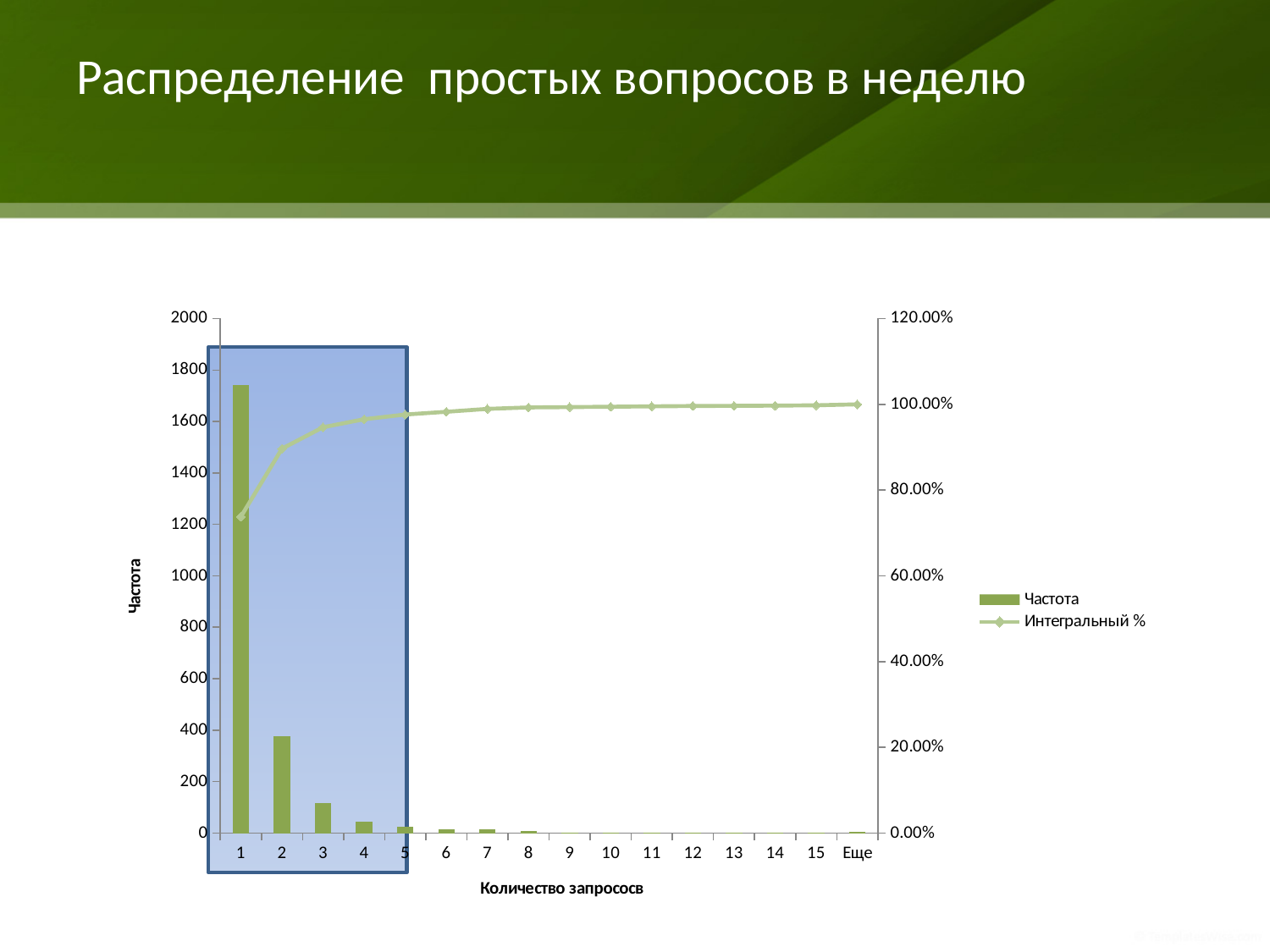
Is the Частота value for category 1 greater or less than 1600? greater Which has a larger Частота value, category 1 or category 2? Category 1 Do the Частота bars rise or fall as you move from category 1 to category 15? Fall Is the Частота value for category 2 greater or less than 400? less How many categories are shown on the x axis? 16 Is the Интегральный % value at category 2 greater or less than 80.00%? greater What kind of chart is shown on the slide? A combined bar and line chart Which category has the highest Частота bar? 1 What is the title of the x axis? Количество запрососв What are the two series named in the legend? Частота and Интегральный % How many series does the legend list? 2